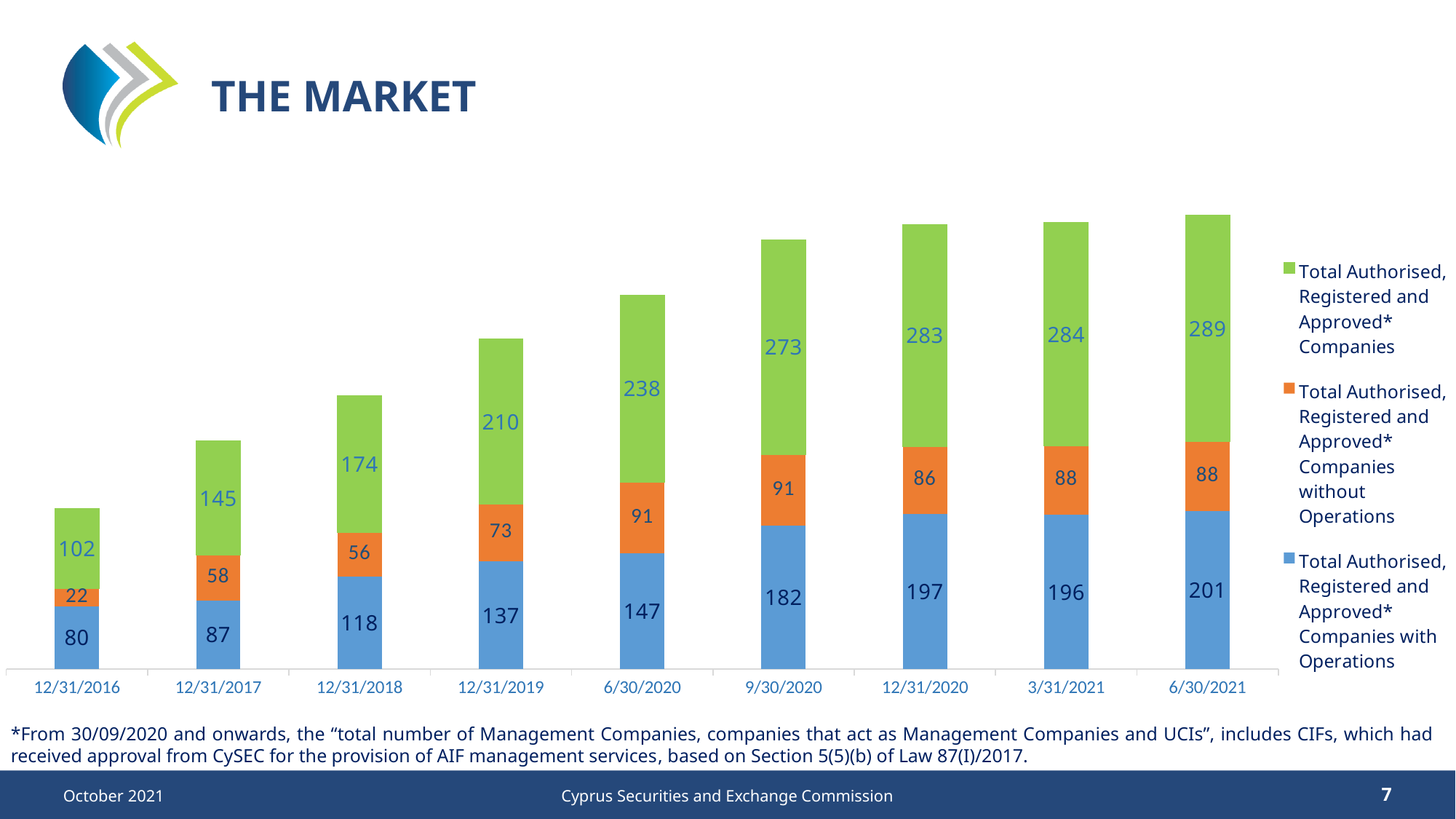
What type of chart is shown on the slide? Stacked bar chart What is the value for Total Authorised, Registered and Approved Companies at 6/30/2021? 289 What is the value for Total Authorised, Registered and Approved Companies with Operations at 12/31/2018? 118 What is the value for Total Authorised, Registered and Approved Companies without Operations at 9/30/2020? 91 Which colour represents Total Authorised, Registered and Approved Companies without Operations? Orange How many dates are shown along the x axis? 9 At which date is the value for Companies with Operations the lowest? 12/31/2016 Which is larger: the Companies without Operations value at 12/31/2017 or at 12/31/2018? 12/31/2017 At which date is the value for Total Authorised, Registered and Approved Companies the highest? 6/30/2021 How many series does the legend list? 3 Does the value for Total Authorised, Registered and Approved Companies rise or fall from 12/31/2016 to 6/30/2021? Rise What is the difference between the Companies with Operations values at 12/31/2020 and 12/31/2019? 60